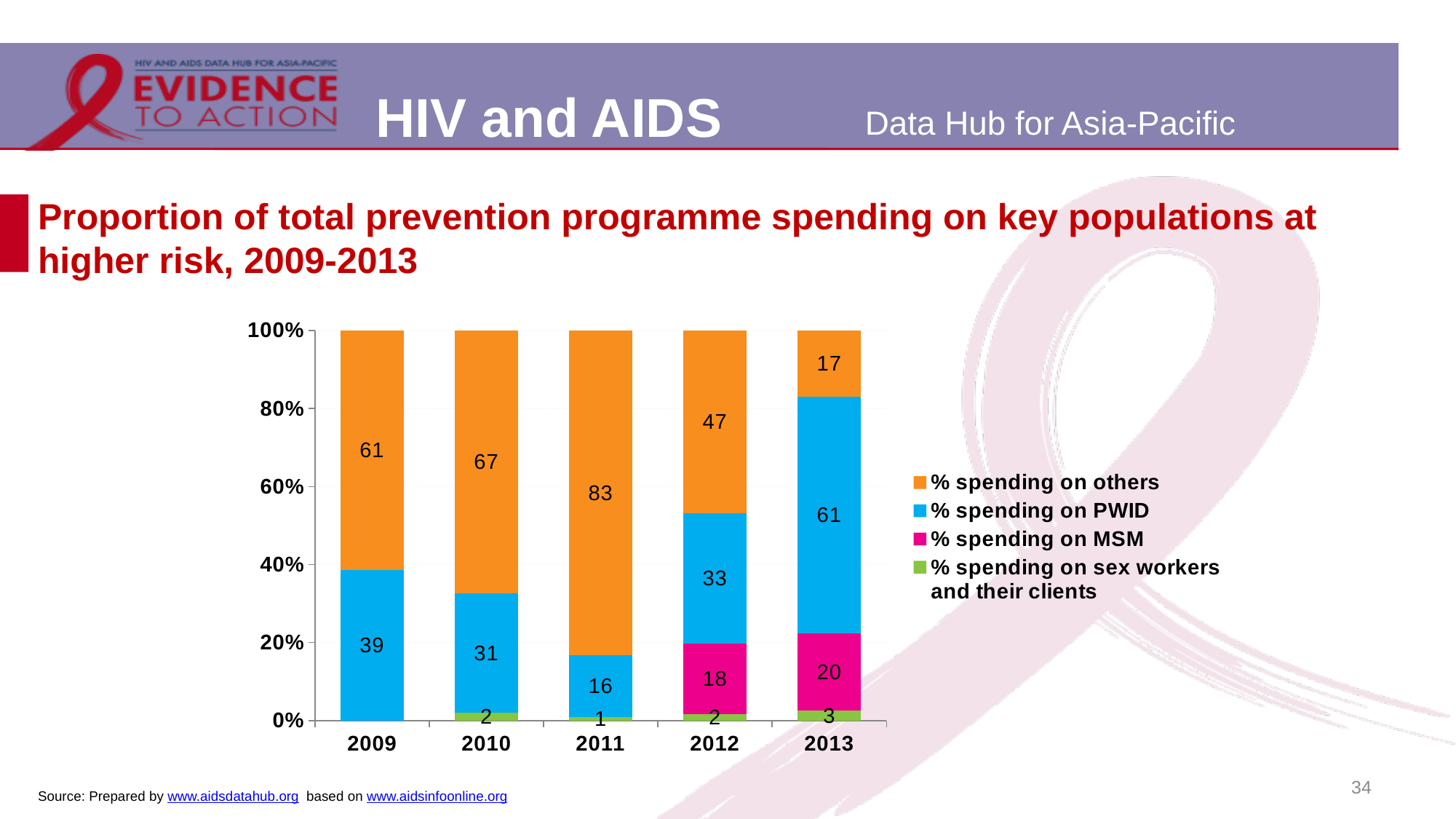
Does % spending on MSM rise or fall from 2012 to 2013? Rise Which is larger in 2012: % spending on others or % spending on PWID? % spending on others What is the difference between % spending on others in 2010 and in 2013? 50 What is the value for % spending on PWID in 2013? 61 What kind of chart is shown on the slide? Stacked bar chart What is the value for % spending on others in 2011? 83 In which year is % spending on others highest? 2011 How many years are shown on the x axis? 5 How many series does the legend list? 4 In which year is % spending on PWID lowest? 2011 What is the value for % spending on MSM in 2012? 18 What is the value for % spending on sex workers and their clients in 2013? 3